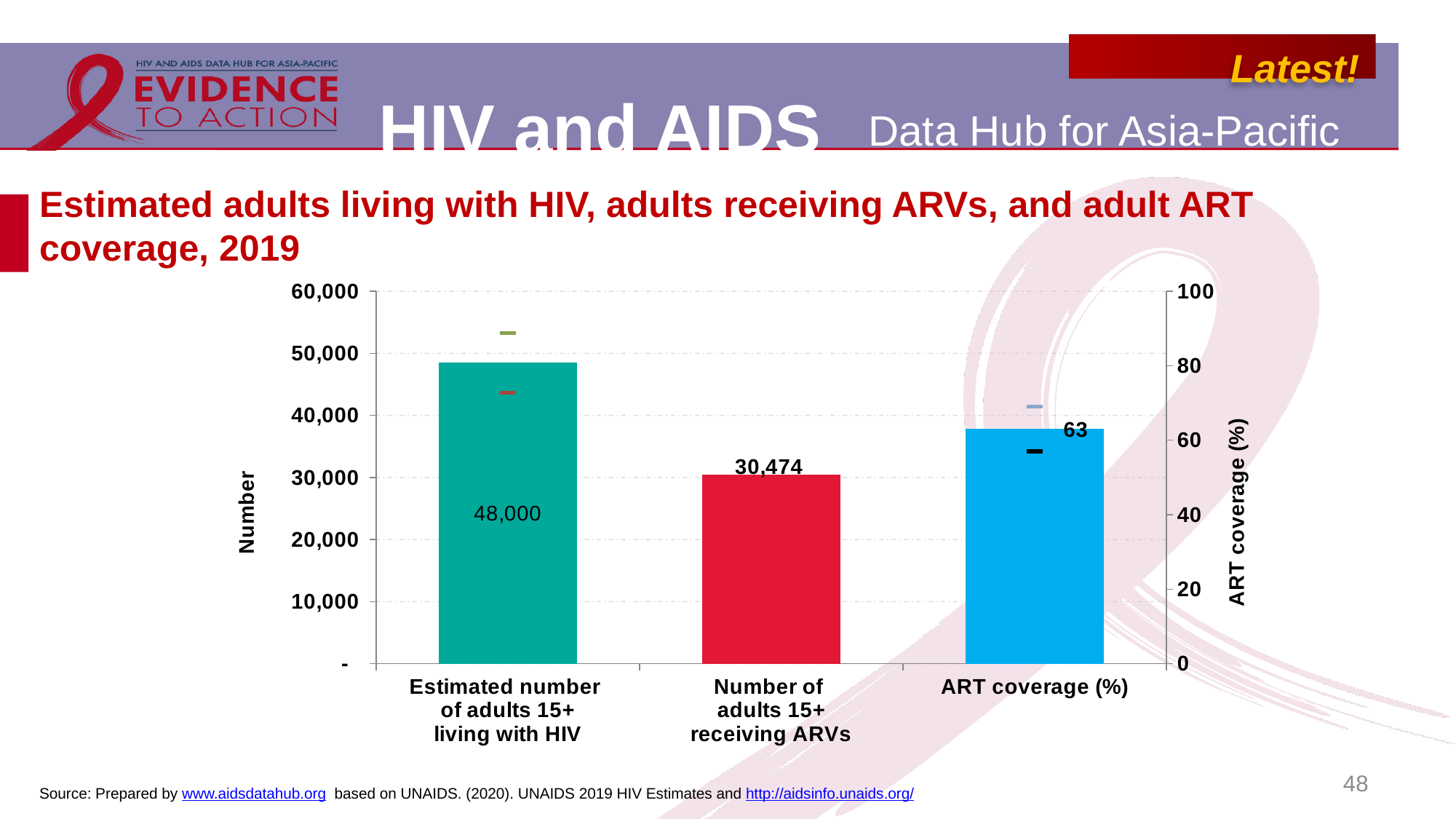
What is the ART coverage (%) value shown on the chart? 63 What is the maximum value shown on the right-hand axis of the chart? 100 What is the estimated number of adults 15+ living with HIV shown on the chart? 48,000 Is the ART coverage (%) value greater or less than 50 on the right-hand axis? greater What is the difference between the estimated number of adults 15+ living with HIV and the number of adults 15+ receiving ARVs? 17,526 What kind of chart is shown on the slide? Bar chart What is the label of the right vertical axis of the chart? ART coverage (%) Is the number of adults 15+ receiving ARVs greater or less than 40,000? less What is the number of adults 15+ receiving ARVs shown on the chart? 30,474 What is the label of the left vertical axis of the chart? Number How many bars are plotted on the chart? 3 Which is larger: the estimated number of adults 15+ living with HIV or the number of adults 15+ receiving ARVs? Estimated number of adults 15+ living with HIV